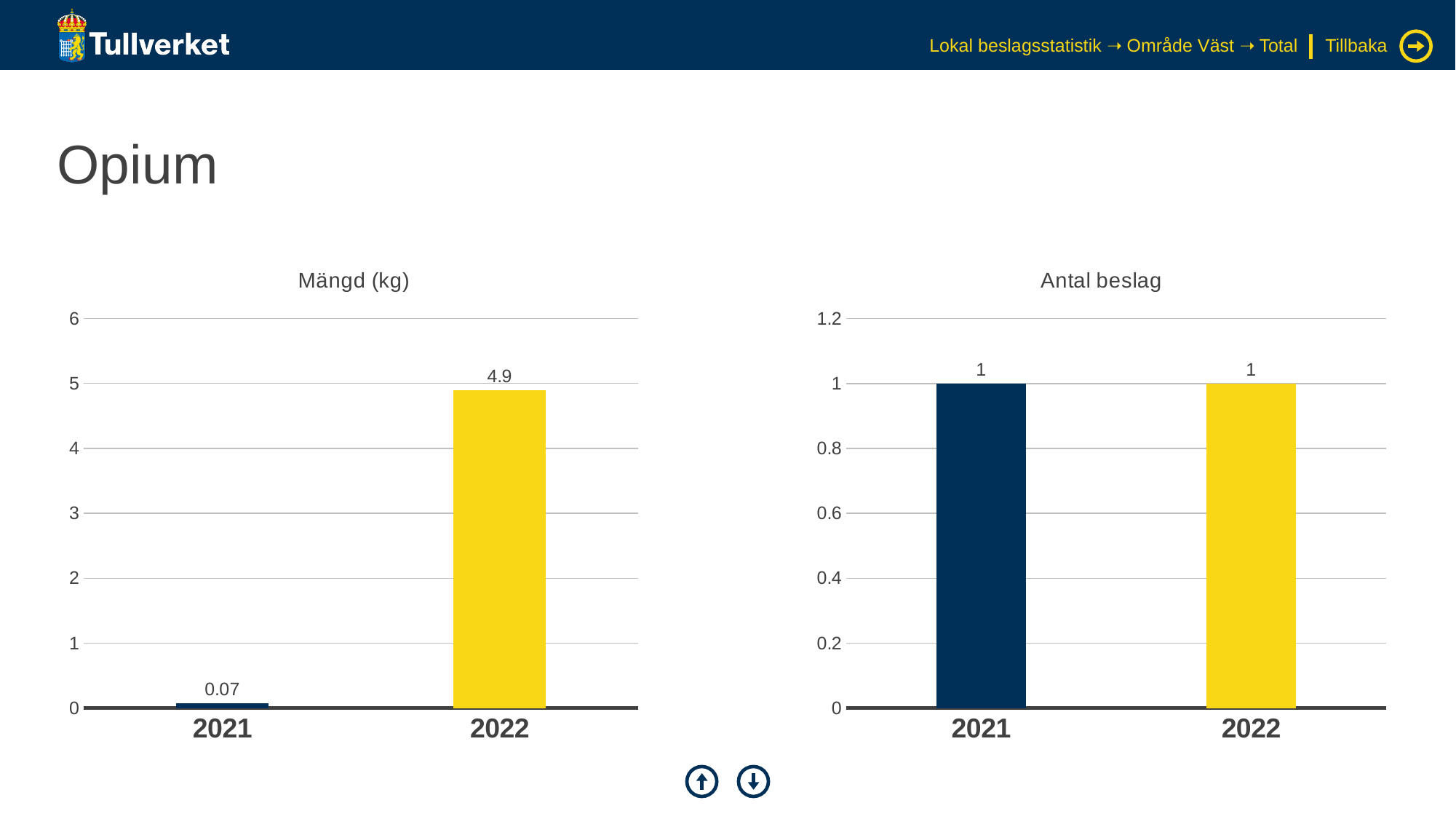
In the 'Mängd (kg)' chart, which year has the highest value? 2022 In the 'Mängd (kg)' chart, is the value for 2022 greater or less than 4? greater In the 'Mängd (kg)' chart, what is the value for 2021? 0.07 In the 'Mängd (kg)' chart, do the values rise or fall from 2021 to 2022? rise In the 'Antal beslag' chart, what is the value for 2021? 1 What kind of chart is the 'Mängd (kg)' chart? bar chart In the 'Mängd (kg)' chart, what is the difference between the values for 2022 and 2021? 4.83 In the 'Antal beslag' chart, what is the value for 2022? 1 What is the title of the chart on the right side of the slide? Antal beslag In the 'Mängd (kg)' chart, which year has the lowest value? 2021 How many categories are shown on the x axis of the 'Antal beslag' chart? 2 In the 'Mängd (kg)' chart, what is the value for 2022? 4.9